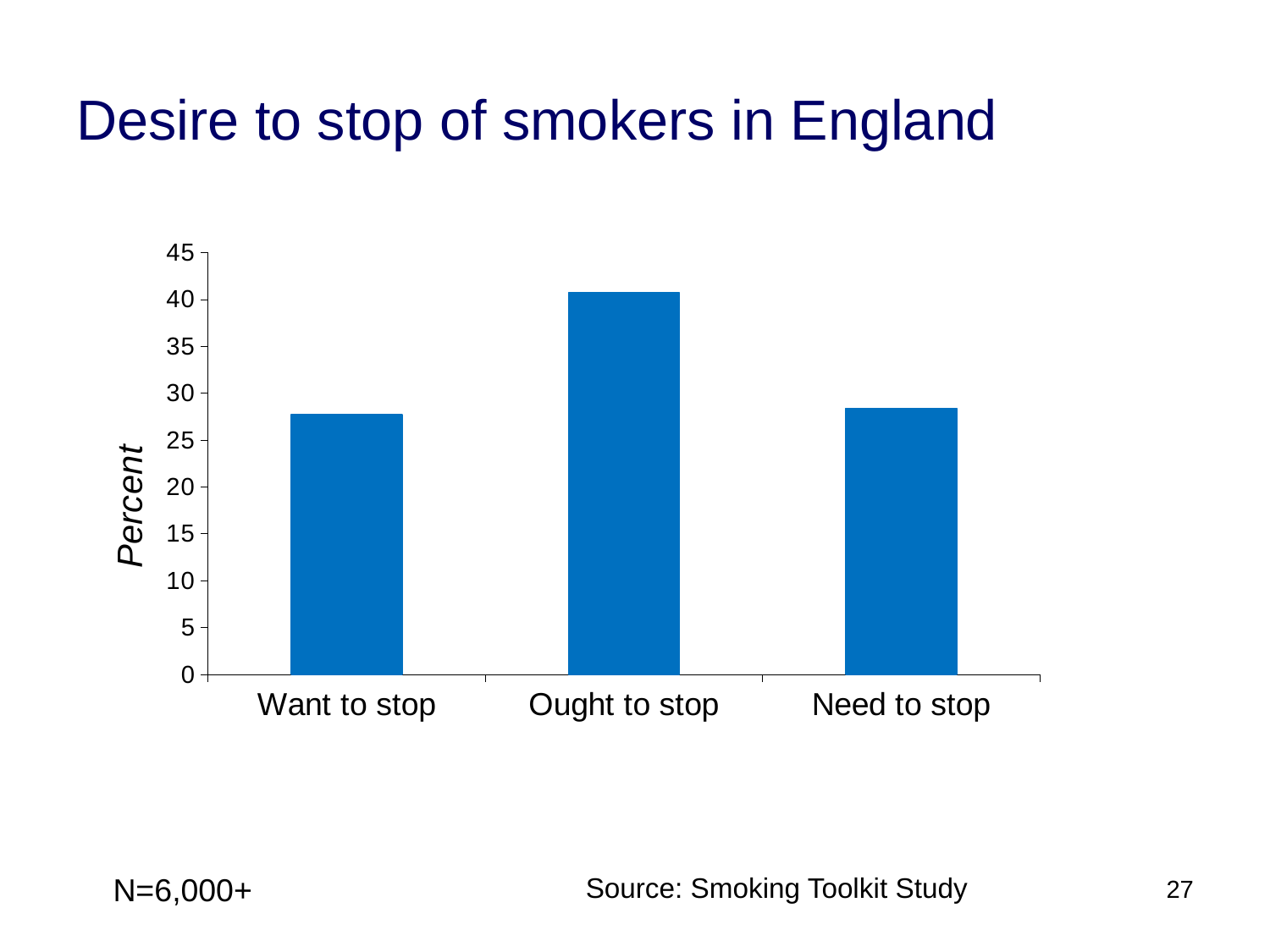
Which is larger, the value for Ought to stop or the value for Want to stop? Ought to stop Is the value for Need to stop greater or less than 30? less What is the label on the y axis of the chart? Percent Which is larger, the value for Ought to stop or the value for Need to stop? Ought to stop Is the value for Want to stop greater or less than 25? greater Is the value for Ought to stop greater or less than 35? greater Which category has the highest value in the chart? Ought to stop How many categories are shown on the x axis of the chart? 3 What is the title of the slide containing the chart? Desire to stop of smokers in England What kind of chart is shown on the slide? bar chart